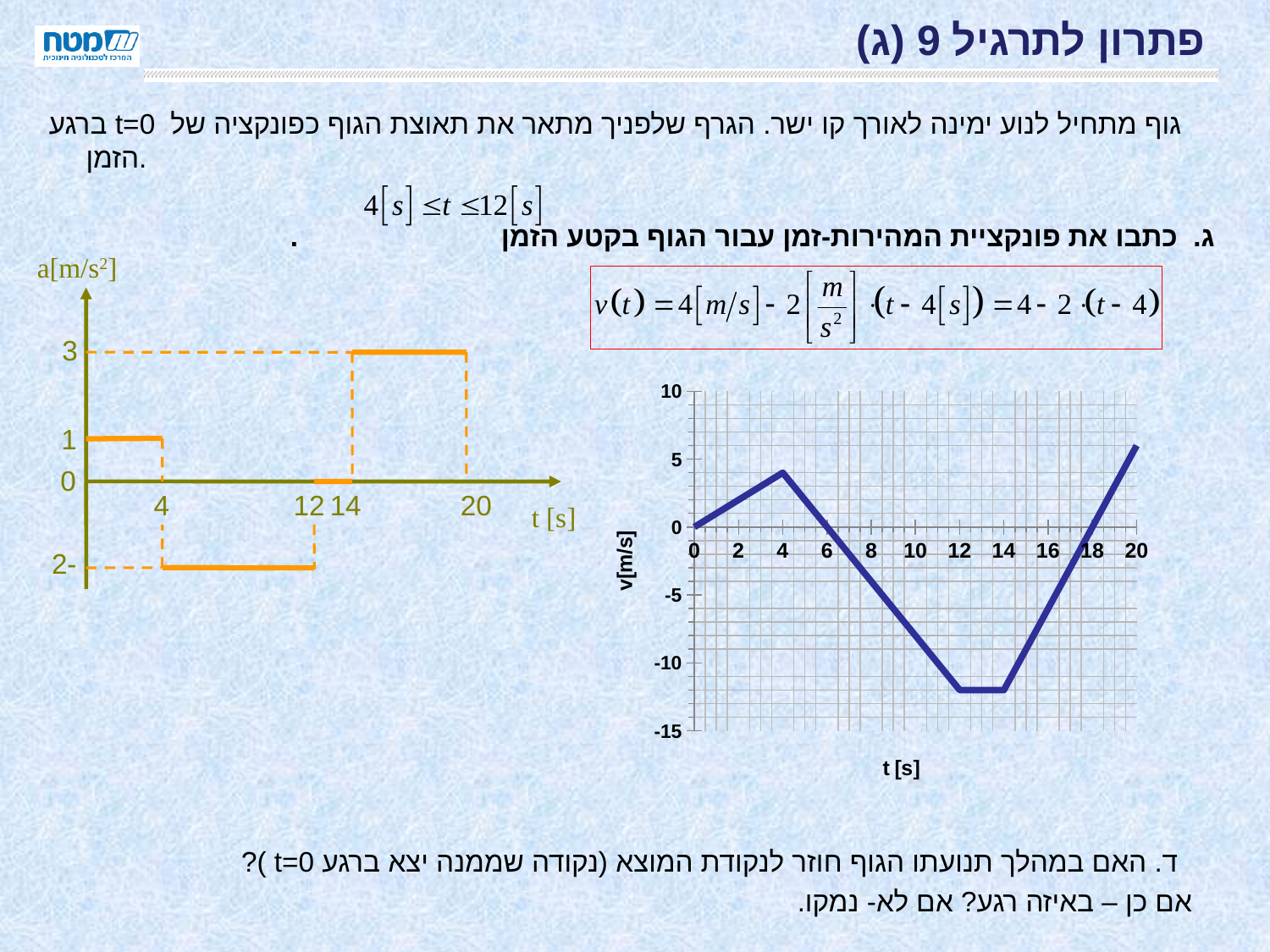
In the acceleration-time graph on the left, what is the acceleration between t=0 and t=4 s? 1 In the velocity-time graph on the right, is the velocity at t=12 s greater or less than -10? less In the velocity-time graph on the right, which is larger: the velocity at t=4 s or at t=20 s? t=20 s In the acceleration-time graph on the left, is the acceleration between t=4 and t=12 s greater or less than 0? less In the acceleration-time graph on the left, what is the acceleration between t=14 and t=20 s? 3 In the velocity-time graph on the right, does the velocity rise or fall between t=4 s and t=12 s? fall In the velocity-time graph on the right, is the velocity at t=20 s greater or less than 5? greater In the acceleration-time graph on the left, during which time interval is the acceleration highest? 14 to 20 s What is the label of the vertical axis of the velocity-time graph on the right? v[m/s] In the velocity-time graph on the right, does the velocity rise or fall between t=14 s and t=20 s? rise In the acceleration-time graph on the left, what is the acceleration between t=12 and t=14 s? 0 What kind of chart is the velocity-time graph on the right of the slide? line chart